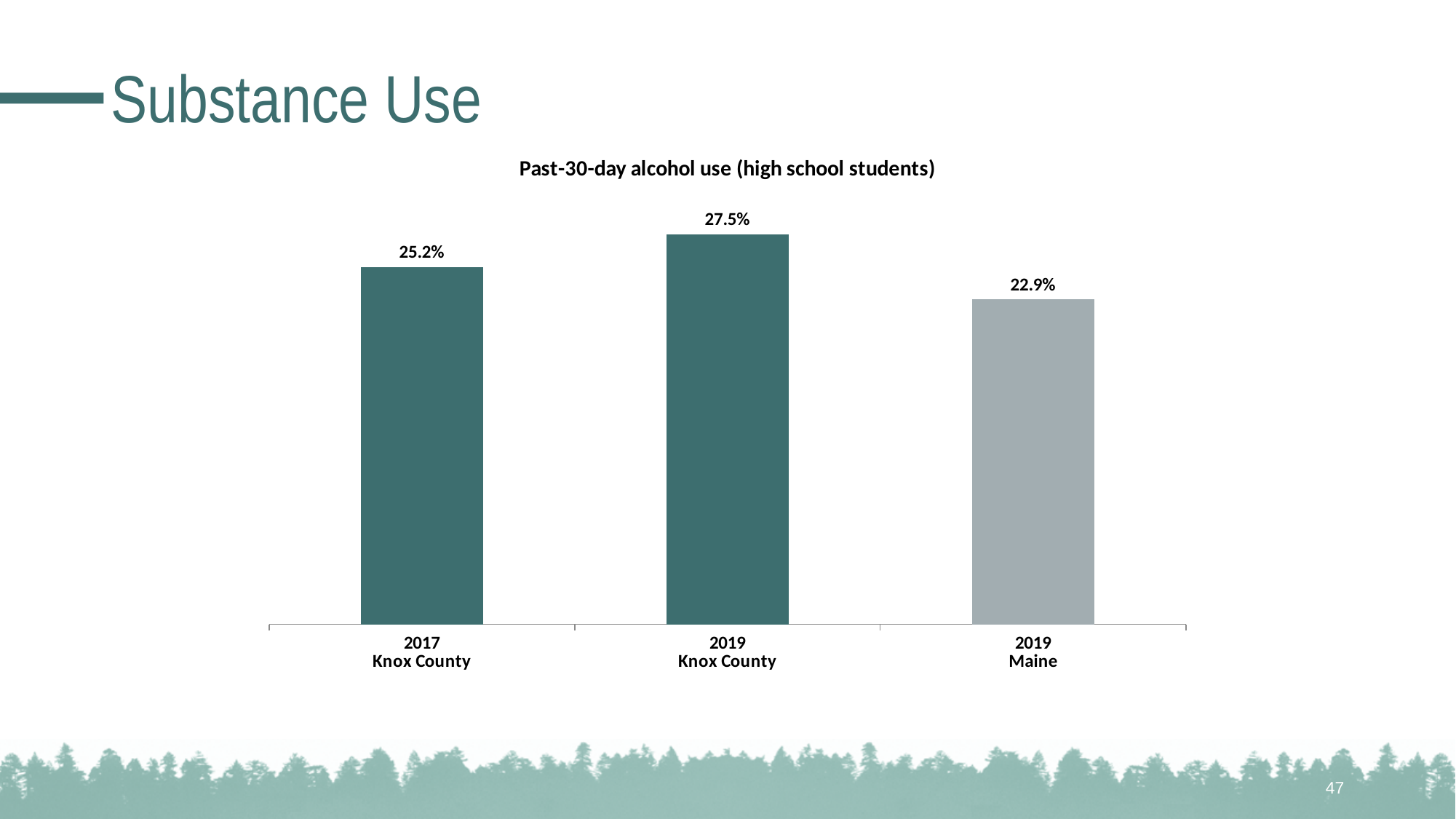
Which is larger, the 2017 Knox County value or the 2019 Maine value? 2017 Knox County What kind of chart is shown on the slide? Bar chart What is the past-30-day alcohol use value for 2019 Knox County? 27.5% Which category has the highest past-30-day alcohol use? 2019 Knox County How many bars are shown in the chart? 3 What is the past-30-day alcohol use value for 2019 Maine? 22.9% What is the title of the chart? Past-30-day alcohol use (high school students) Which category has the lowest past-30-day alcohol use? 2019 Maine Did past-30-day alcohol use in Knox County rise or fall from 2017 to 2019? Rise What is the difference between the 2019 Knox County and 2019 Maine values? 4.6% What is the difference between the 2019 Knox County and 2017 Knox County values? 2.3% What is the past-30-day alcohol use value for 2017 Knox County? 25.2%